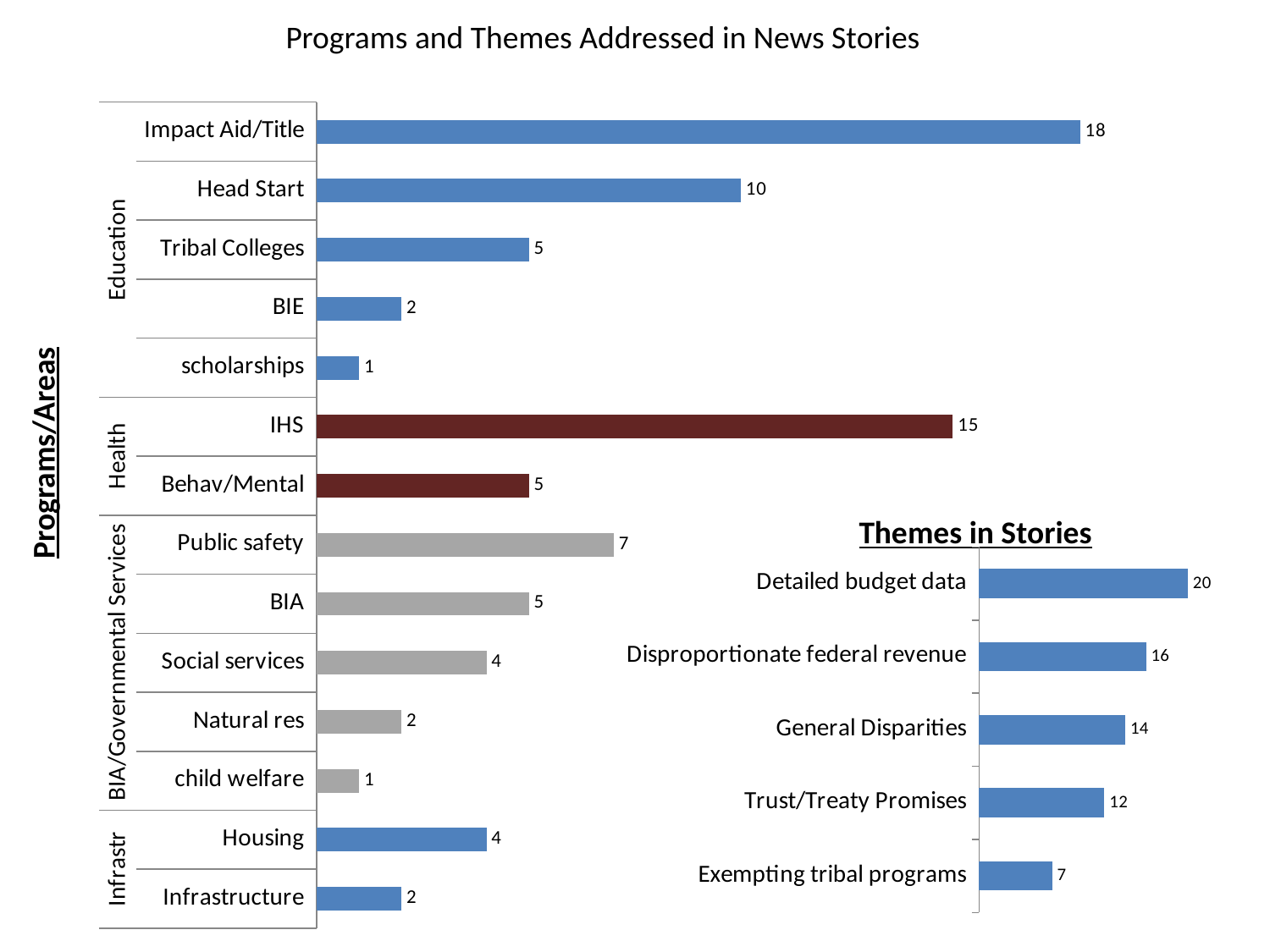
In the Programs/Areas chart, how many categories are plotted? 14 In the Programs/Areas chart, what colour are the Health bars (IHS and Behav/Mental)? Dark red In the Themes in Stories chart, which theme has the lowest value? Exempting tribal programs In the Themes in Stories chart, what is the difference between Detailed budget data and General Disparities? 6 In the Programs/Areas chart, what is the difference between Head Start and Tribal Colleges? 5 What type of chart is the Themes in Stories chart? Bar chart In the Programs/Areas chart, which category has the highest value? Impact Aid/Title In the Themes in Stories chart, what is the value for Trust/Treaty Promises? 12 In the Themes in Stories chart, how many themes are plotted? 5 In the Programs/Areas chart, what is the value for Impact Aid/Title? 18 In the Programs/Areas chart, which is larger, Public safety or Social services? Public safety In the Programs/Areas chart, what is the value for IHS? 15